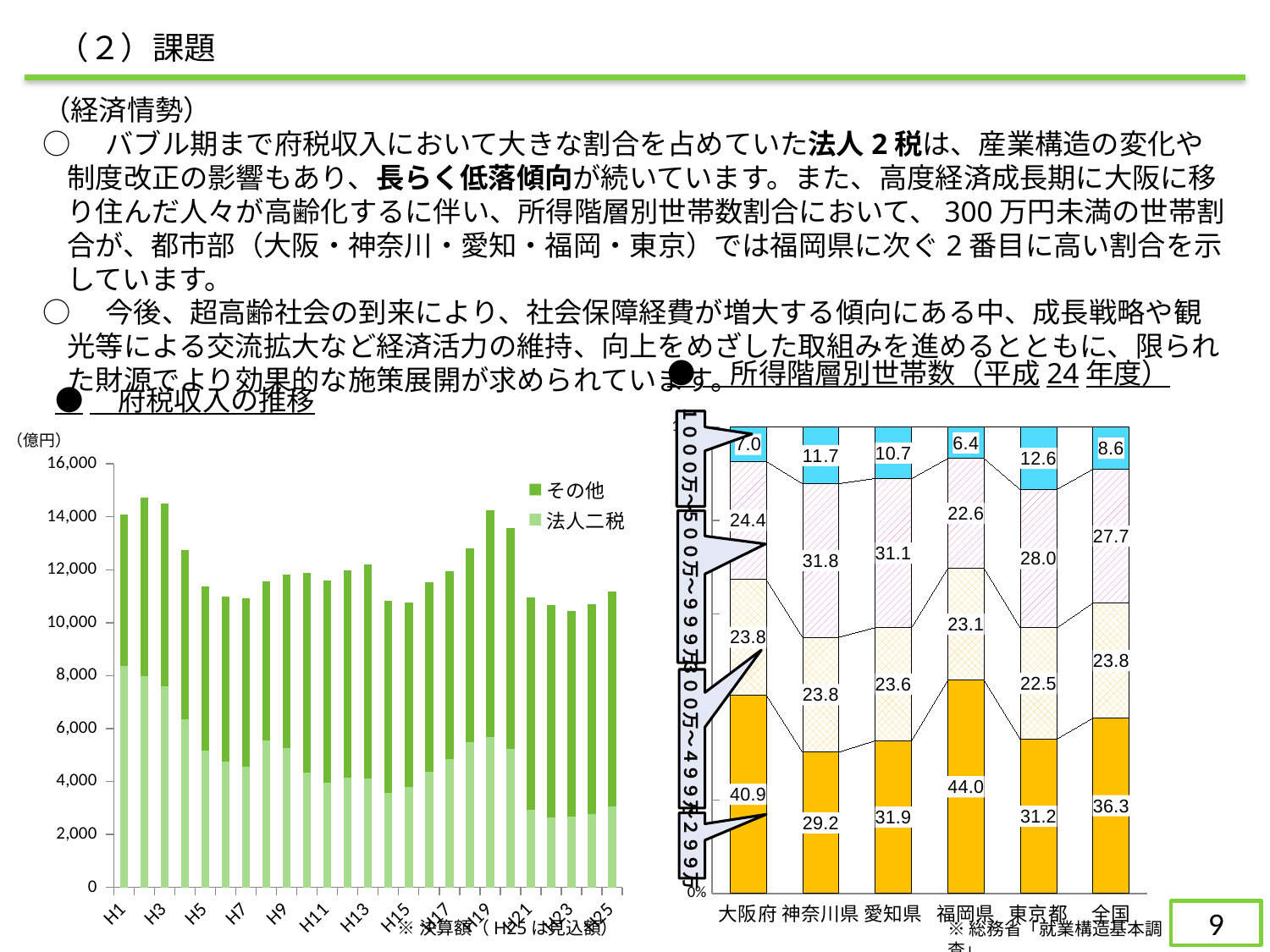
In the 所得階層別世帯数（平成24年度） chart on the right, what is the value of the 500万～999万 segment for 神奈川県? 31.8 In the 府税収入の推移 chart on the left, is the total value for H3 greater or less than 14,000? greater In the 所得階層別世帯数（平成24年度） chart on the right, what is the value of the top segment (1000万～) for 東京都? 12.6 In the 所得階層別世帯数（平成24年度） chart on the right, which has the larger top-segment (1000万～) value, 東京都 or 大阪府? 東京都 In the 所得階層別世帯数（平成24年度） chart on the right, what is the difference between the bottom-segment (～299万) values for 福岡県 and 大阪府? 3.1 In the 所得階層別世帯数（平成24年度） chart on the right, which category has the lowest value for the bottom segment (～299万)? 神奈川県 What kind of chart is the 府税収入の推移 chart on the left? bar chart In the 府税収入の推移 chart on the left, is the total value for H16 greater or less than 12,000? less In the 所得階層別世帯数（平成24年度） chart on the right, which category has the highest value for the bottom segment (～299万)? 福岡県 In the 所得階層別世帯数（平成24年度） chart on the right, what is the value of the bottom segment (～299万) for 大阪府? 40.9 How many categories are shown on the x axis of the 所得階層別世帯数（平成24年度） chart on the right? 6 How many series does the legend of the 府税収入の推移 chart on the left list? 2